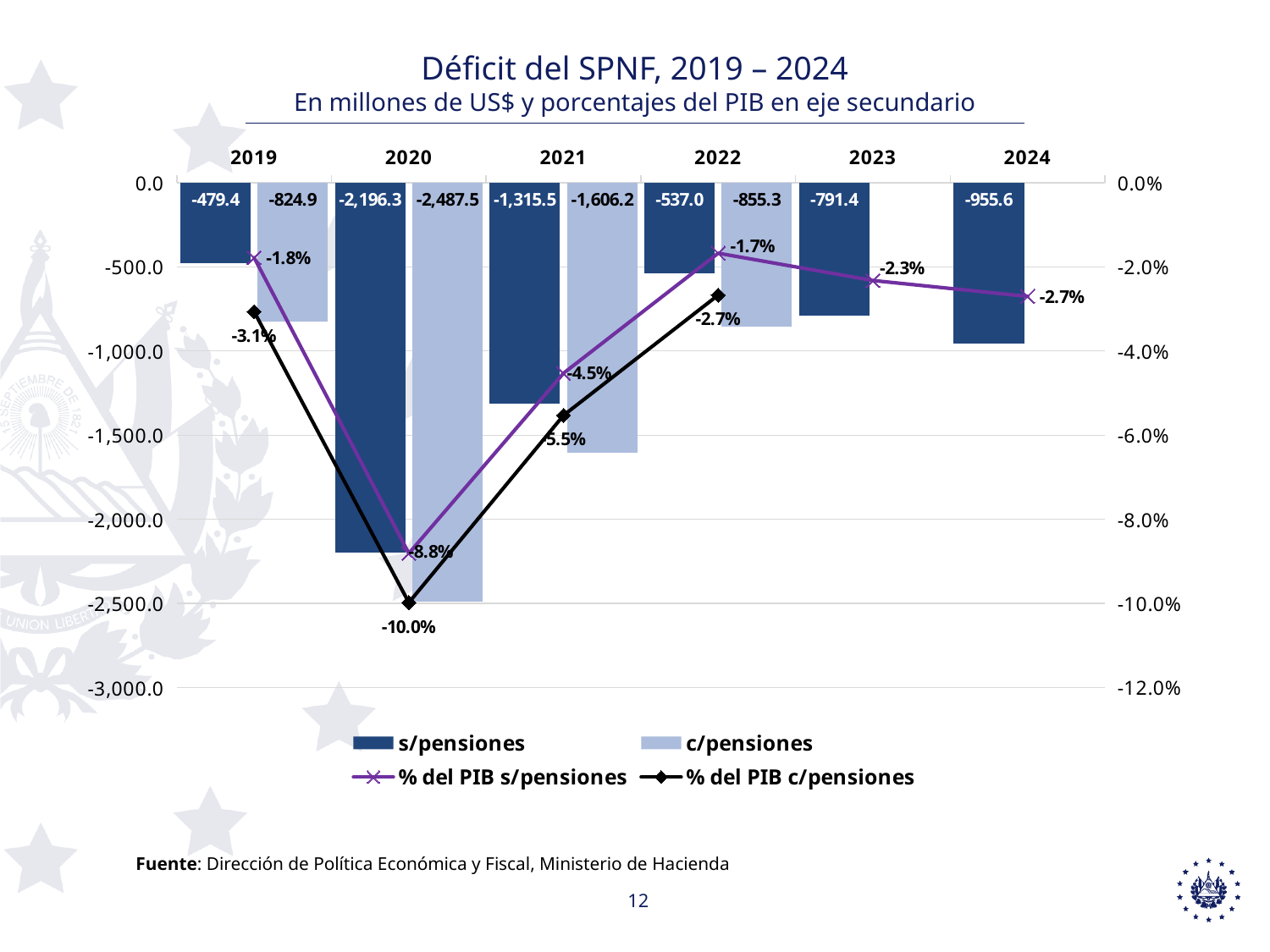
What is the difference between the c/pensiones and s/pensiones values in 2020? 291.2 In which year is the s/pensiones deficit the largest (most negative)? 2020 In which year is the s/pensiones deficit the smallest in magnitude? 2019 Do the % del PIB s/pensiones values rise or fall from 2022 to 2024? Fall How many series does the legend list? 4 What is the value of the s/pensiones bar for 2020? -2,196.3 How many years are shown on the x axis? 6 What kind of chart is this? Combination bar and line chart What is the % del PIB s/pensiones value for 2023? -2.3% What is the value of the c/pensiones bar for 2021? -1,606.2 What is the % del PIB c/pensiones value for 2020? -10.0% Which year has a larger s/pensiones deficit, 2023 or 2024? 2024